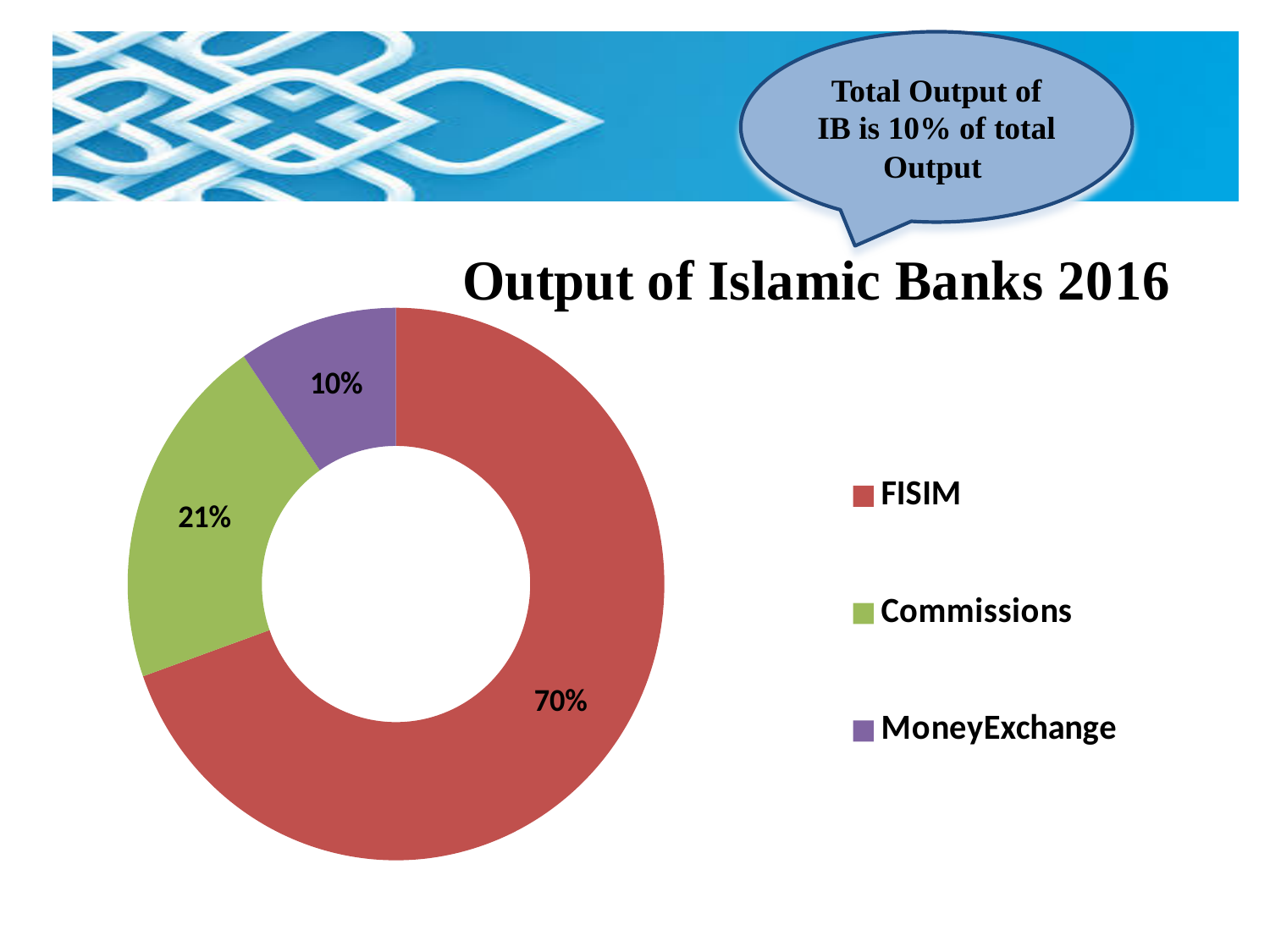
What is the difference in percentage points between the FISIM and Commissions shares? 49 What is the difference in percentage points between the Commissions and MoneyExchange shares? 11 Which category has the smallest share in the Output of Islamic Banks 2016 chart? MoneyExchange What share of the Output of Islamic Banks 2016 chart is Commissions? 21% What share of the Output of Islamic Banks 2016 chart is FISIM? 70% What share of the Output of Islamic Banks 2016 chart is MoneyExchange? 10% Which colour represents FISIM in the chart? Red Which category has the largest share in the Output of Islamic Banks 2016 chart? FISIM How many categories are shown in the Output of Islamic Banks 2016 chart? 3 What kind of chart is used to show the Output of Islamic Banks 2016? Pie chart (doughnut) What is the title of the chart on the slide? Output of Islamic Banks 2016 Which is larger, the share for Commissions or the share for MoneyExchange? Commissions